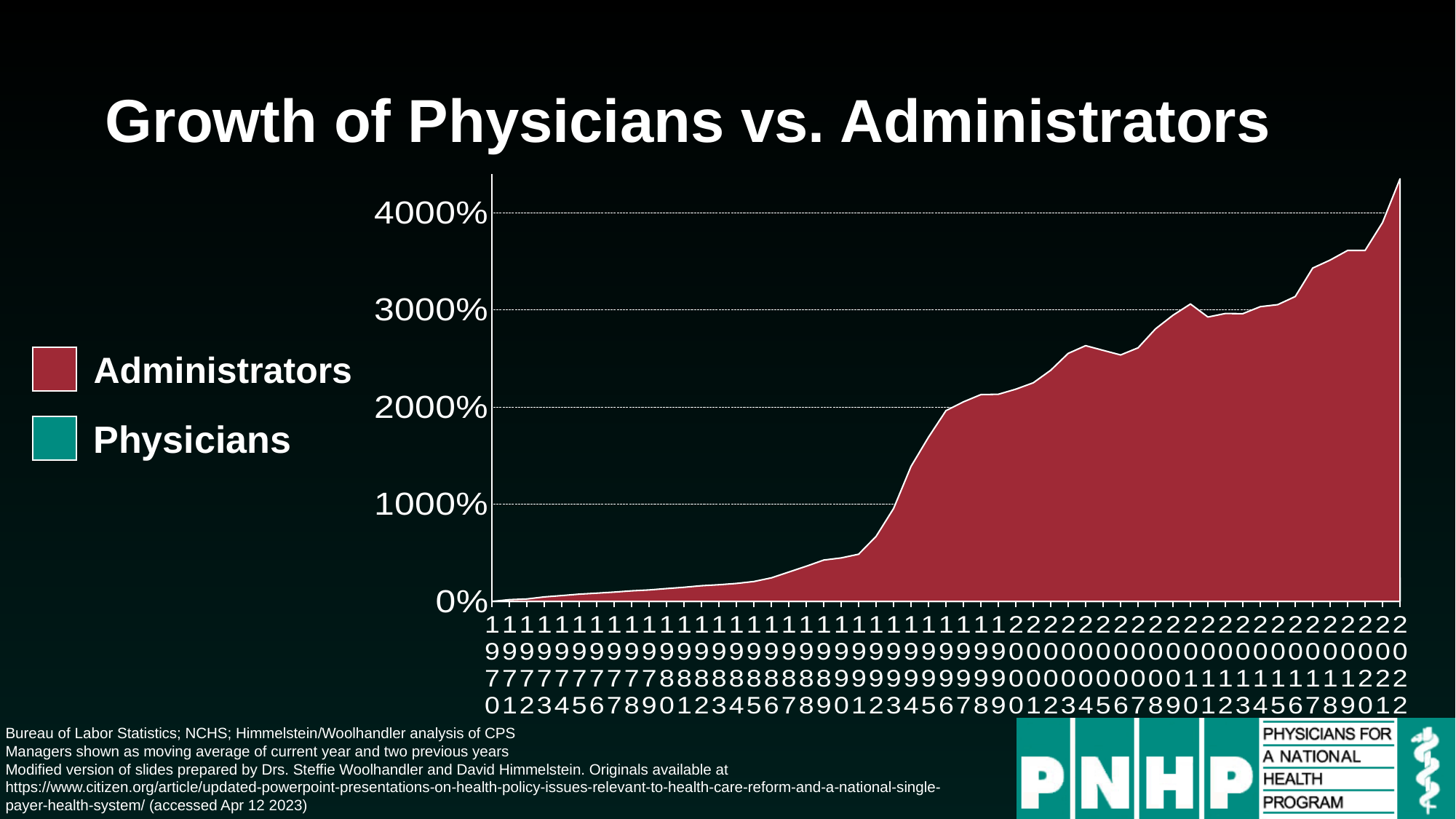
Is the Administrators value for 1990 greater or less than 1000%? less In which year is the Administrators series at its lowest value? 1970 How many series does the legend list? 2 Is the Administrators value for 2022 greater or less than 4000%? greater In which year does the Administrators series reach its highest value? 2022 Which colour represents Administrators in the legend? red What kind of chart is shown on the slide? area chart Is the Administrators value for 2005 greater or less than 2000%? greater What is the title of the chart? Growth of Physicians vs. Administrators Does the Administrators series generally rise or fall from 1970 to 2022? rise Which year has the larger Administrators value, 1980 or 2010? 2010